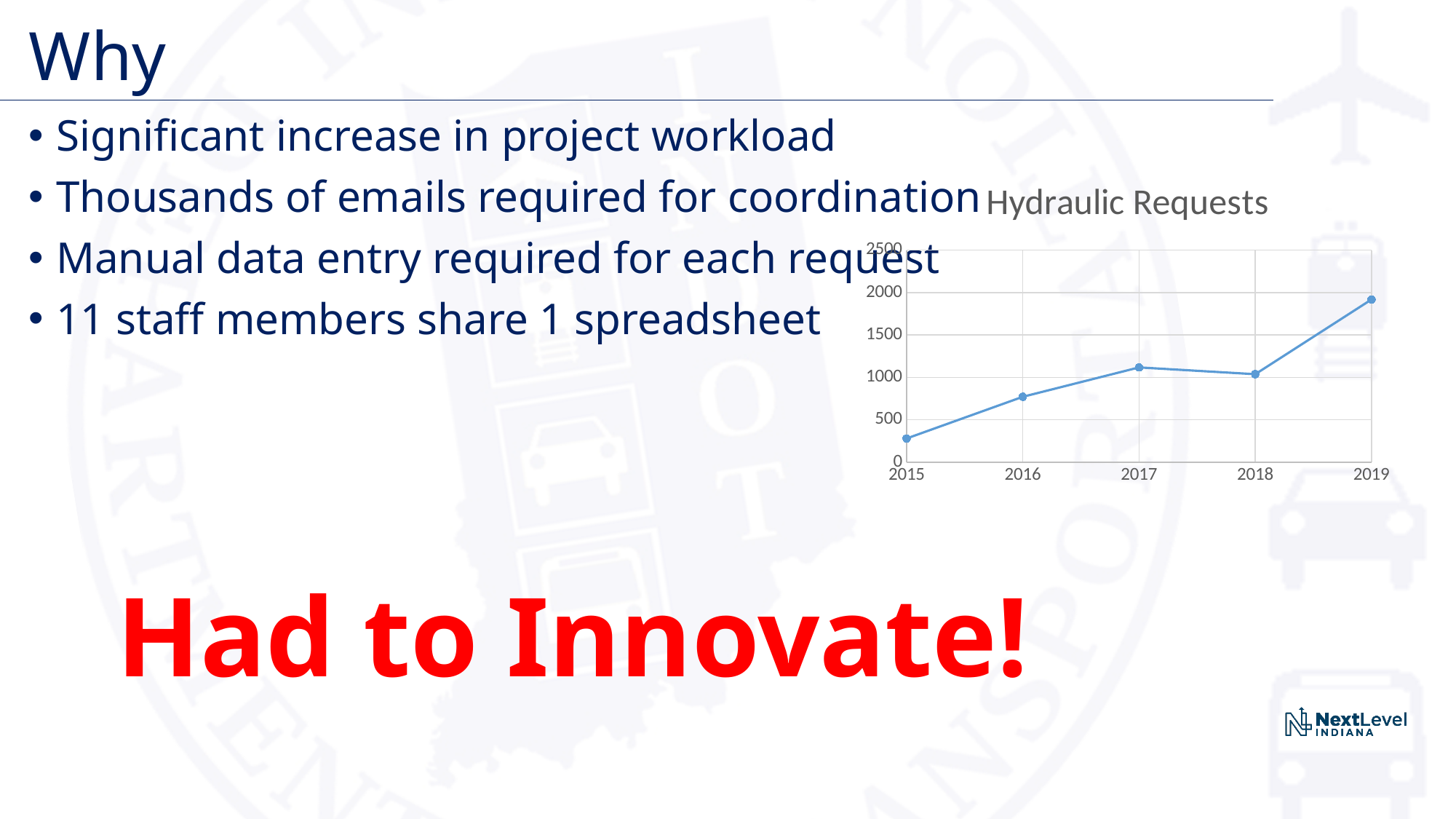
What kind of chart is shown on the slide? line chart Is the value for 2017 in the Hydraulic Requests chart greater or less than 1000? greater How many years are plotted on the x axis of the Hydraulic Requests chart? 5 What is the highest value shown on the y axis of the Hydraulic Requests chart? 2500 In the Hydraulic Requests chart, which year has the larger value, 2016 or 2018? 2018 Which year has the lowest value in the Hydraulic Requests chart? 2015 Is the value for 2016 in the Hydraulic Requests chart greater or less than 1000? less Is the value for 2019 in the Hydraulic Requests chart greater or less than 1500? greater Overall, do the values in the Hydraulic Requests chart rise or fall from 2015 to 2019? rise What is the title of the chart on the slide? Hydraulic Requests Which year has the highest value in the Hydraulic Requests chart? 2019